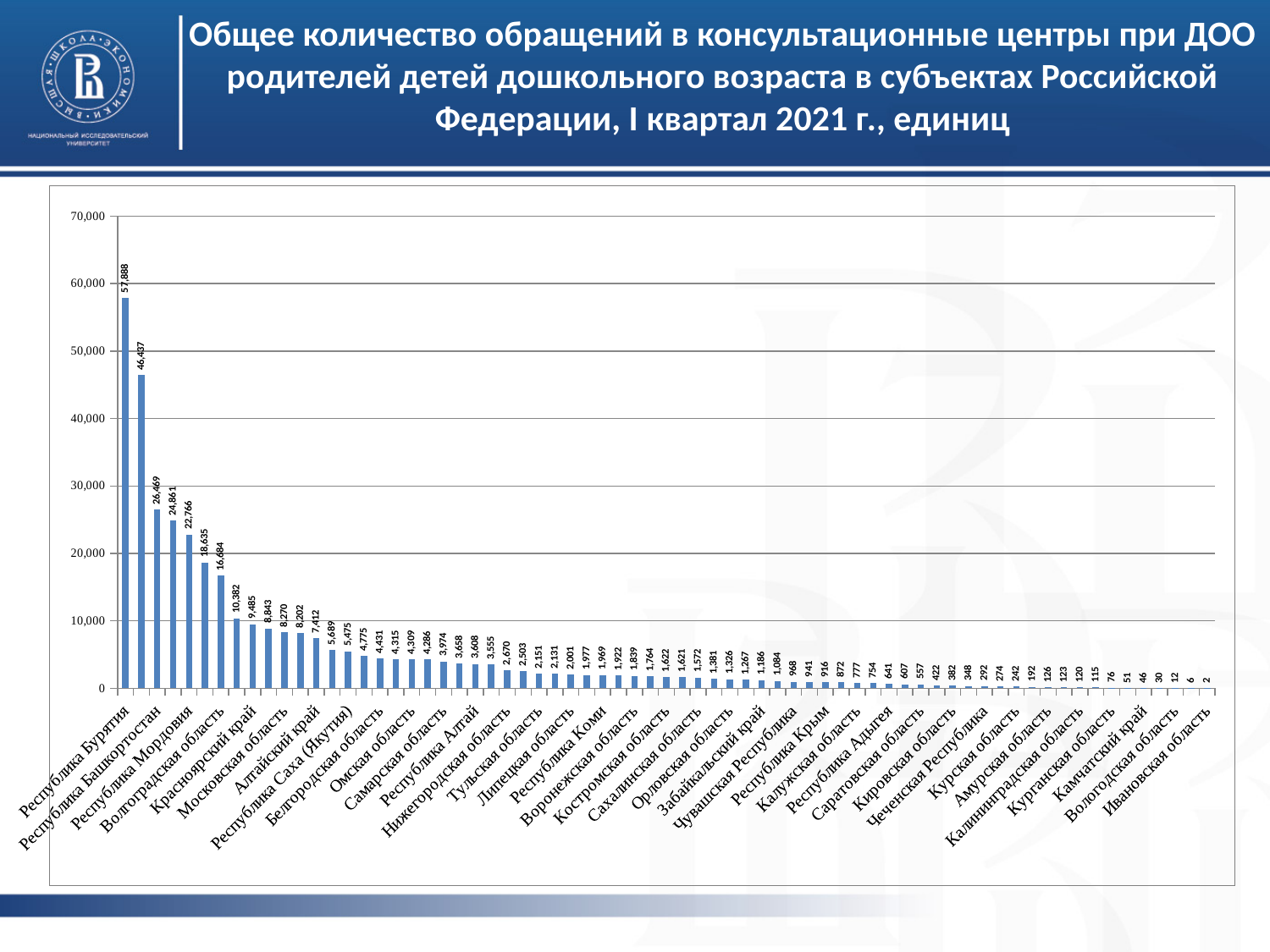
Which region has the lowest number of requests? Ивановская область Is the value for Республика Бурятия greater or less than 50,000? greater What is the value for Республика Башкортостан? 26,469 What is the value for Республика Бурятия? 57,888 What type of chart is shown on the slide? bar chart Which is larger, the value for Республика Бурятия or the value for Республика Башкортостан? Республика Бурятия What period does the chart title say the data refers to? I квартал 2021 г. Which region has the highest number of requests? Республика Бурятия Is the value for Республика Мордовия greater or less than 30,000? less What is the value for Ивановская область? 2 What is the difference between the values for Республика Бурятия and Ивановская область? 57,886 Do the values rise or fall from left to right along the x axis? fall